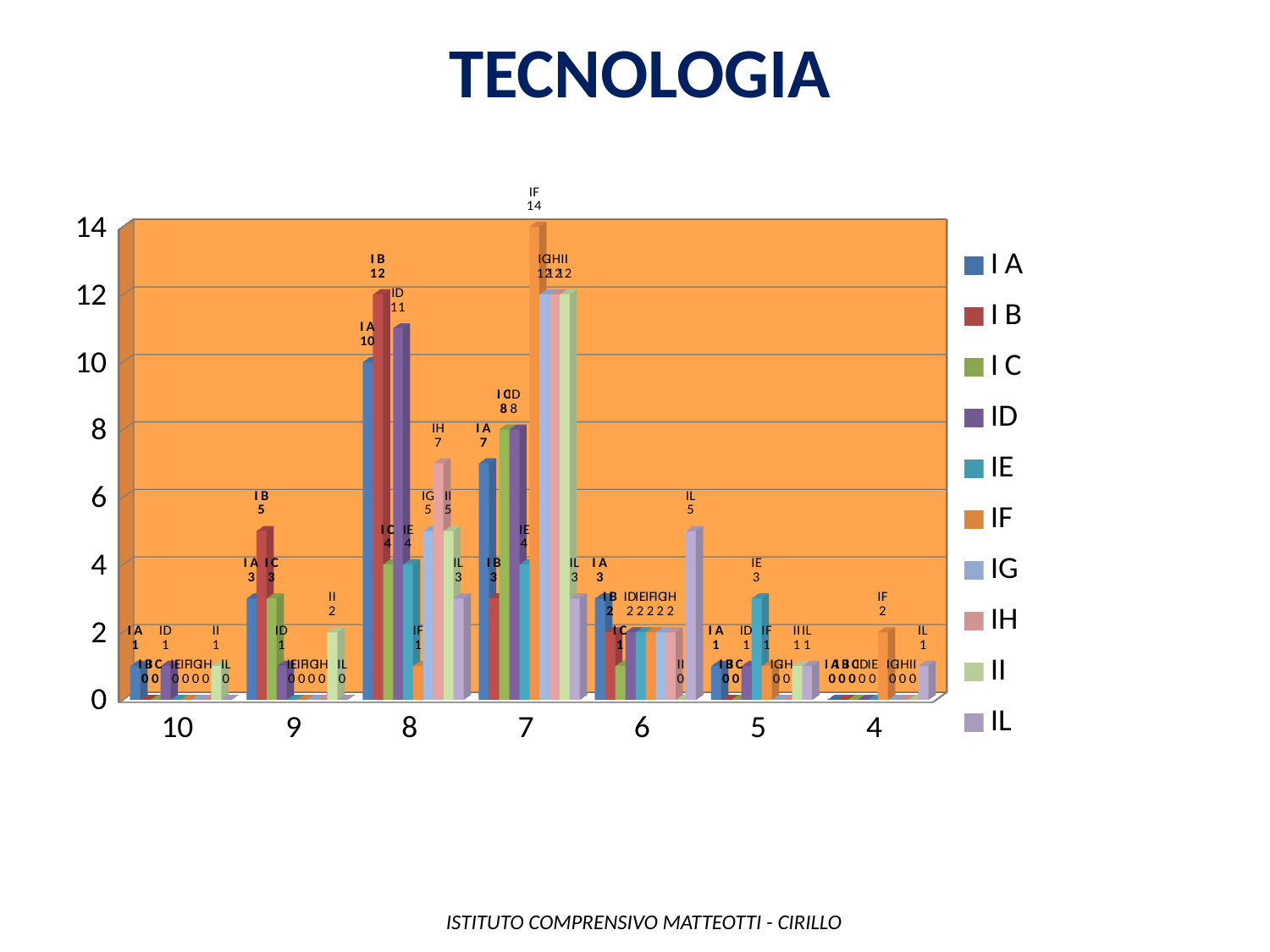
What is the value for series IF at category 7? 14 Which series has the highest value at category 8? I B Which series has the highest value at category 7? IF What is the value for series IH at category 8? 7 How many categories are shown on the x axis? 7 What kind of chart is shown on the slide? Bar chart What is the value for series I B at category 8? 12 How many series does the legend list? 10 At category 8, which is larger: the value for ID or the value for I A? ID What is the value for series IL at category 6? 5 What is the value for series IE at category 5? 3 What is the difference between the I B and I A values at category 8? 2